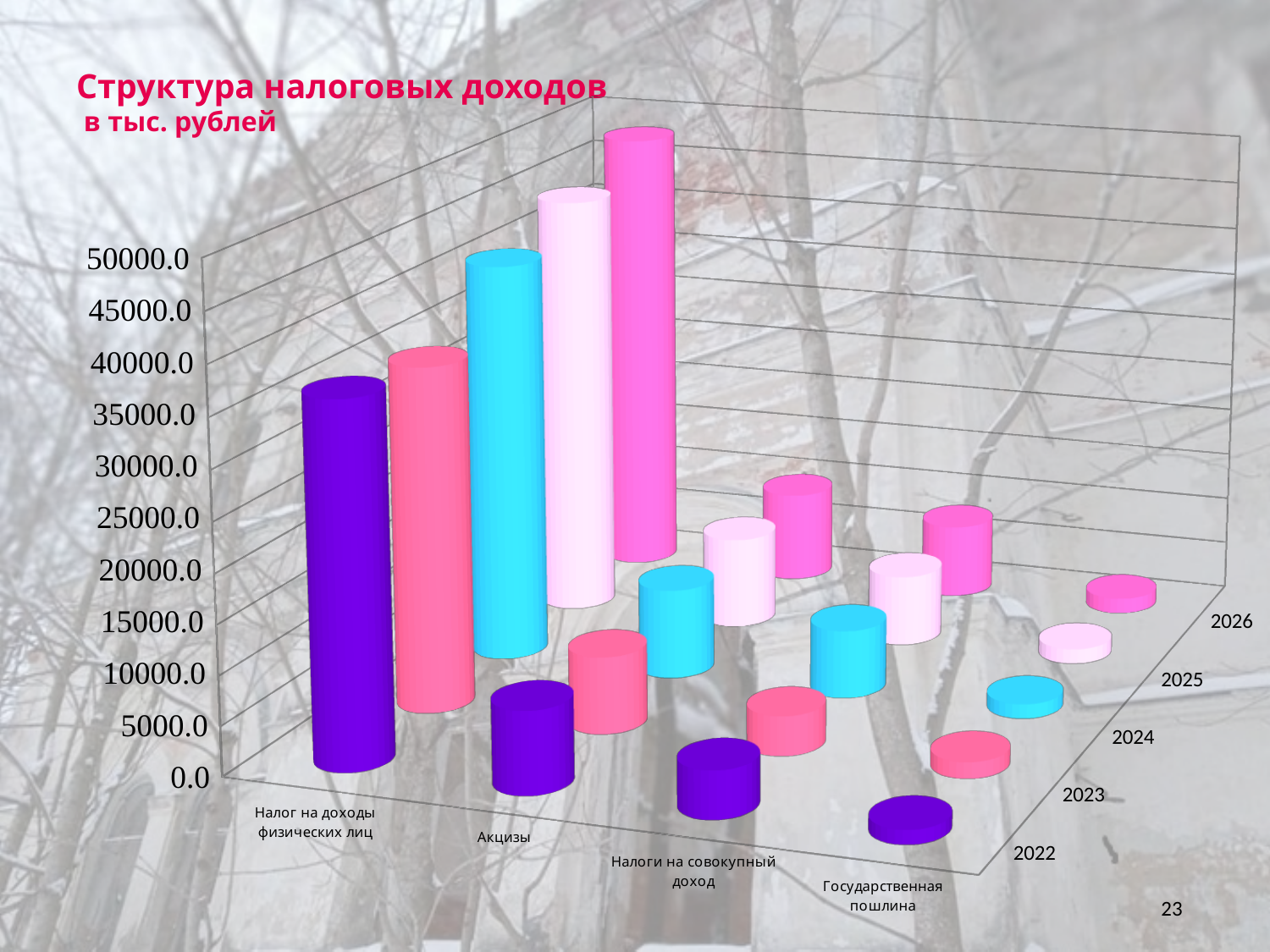
Is the value for Акцизы in 2022 greater or less than 20000.0? less What kind of chart is shown on the slide? bar chart Is the value for Государственная пошлина in 2022 greater or less than 5000.0? less How many tax categories are shown along the category axis? 4 What is the title of the chart? Структура налоговых доходов Do the values for Налог на доходы физических лиц rise or fall from 2022 to 2026? rise Is the value for Налог на доходы физических лиц in 2022 greater or less than 20000.0? greater In what units are the values on the chart expressed, according to the subtitle? в тыс. рублей Which category has the highest values on the chart? Налог на доходы физических лиц How many years (series) are plotted on the chart? 5 Which category has the lowest values on the chart? Государственная пошлина Which is larger in 2026: Налог на доходы физических лиц or Акцизы? Налог на доходы физических лиц